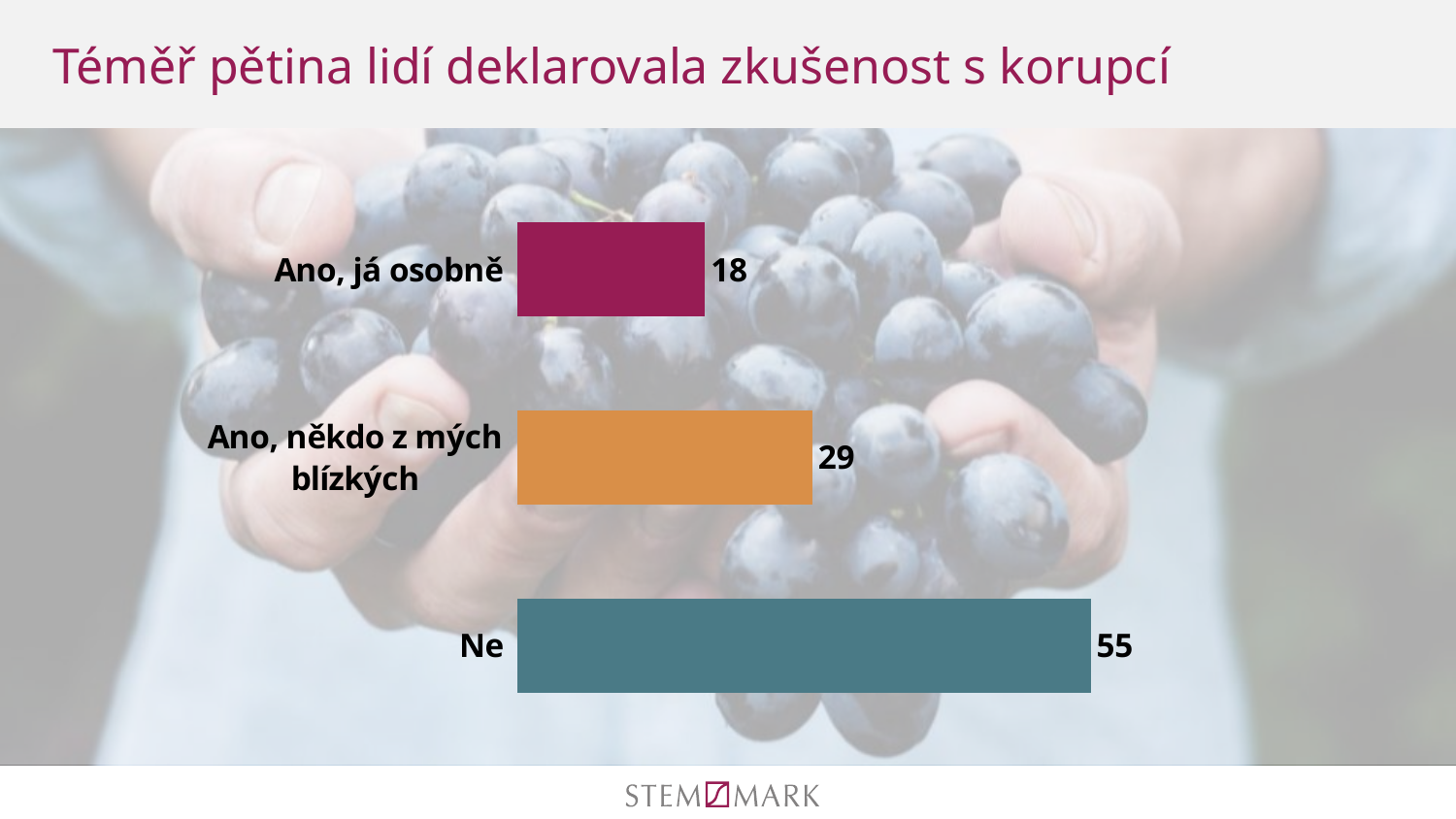
Which category has the highest value? Ne How many categories are shown in the chart? 3 Which is larger, the value for "Ano, já osobně" or the value for "Ano, někdo z mých blízkých"? Ano, někdo z mých blízkých What is the value for "Ano, já osobně"? 18 What kind of chart is shown on the slide? bar chart What is the title of the slide? Téměř pětina lidí deklarovala zkušenost s korupcí What is the difference between the values for "Ano, někdo z mých blízkých" and "Ano, já osobně"? 11 What is the difference between the values for "Ne" and "Ano, někdo z mých blízkých"? 26 What is the value for "Ano, někdo z mých blízkých"? 29 What is the value for "Ne"? 55 Which category has the lowest value? Ano, já osobně What colour is the bar for "Ne"? teal